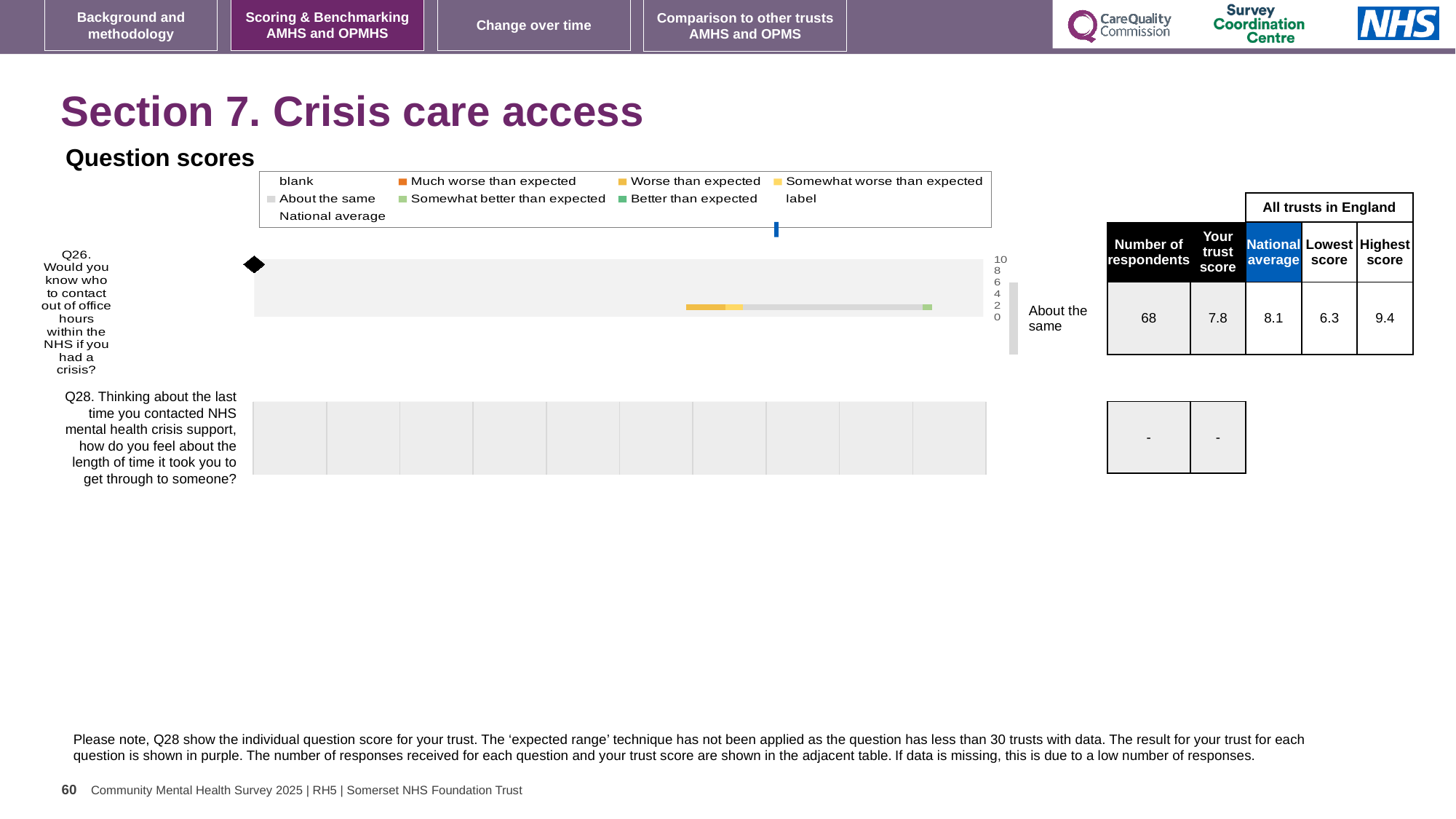
What is the trust score for Q26 (knowing who to contact out of office hours in a crisis)? 7.8 What is the national average score for Q26? 8.1 How many questions are plotted in the question scores chart? 2 How many respondents answered Q26? 68 What is the difference between the highest and lowest trust scores in England for Q26? 3.1 What kind of chart is used to show the question scores on this slide? bar chart For Q26, which is larger: the trust score or the national average? National average What is the highest score among all trusts in England for Q26? 9.4 Is the trust score for Q26 greater or less than 5 on the chart's axis? greater What is shown in the table for the number of respondents and trust score for Q28? - What benchmark category label is shown next to the Q26 bar? About the same What is the lowest score among all trusts in England for Q26? 6.3